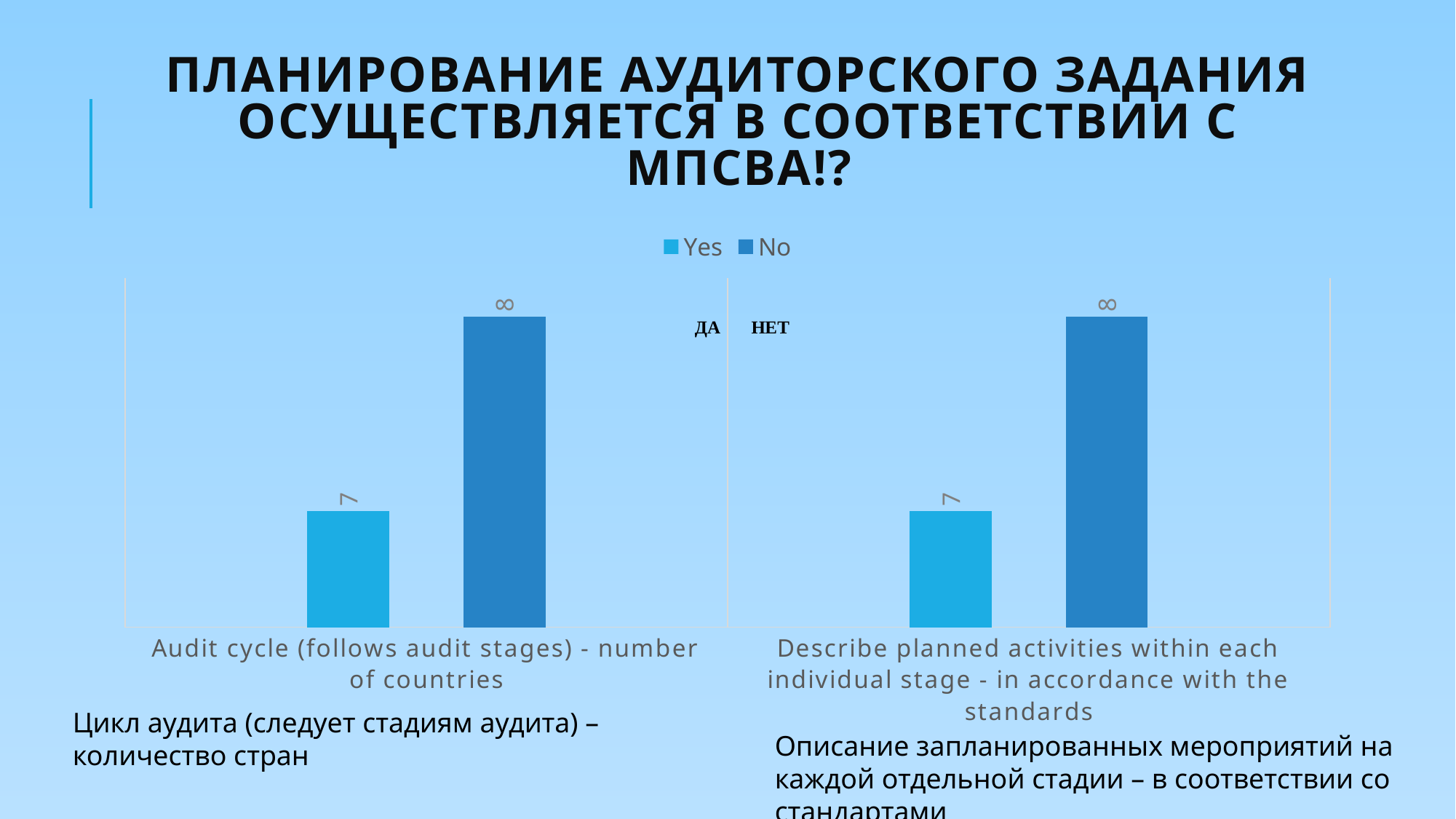
How many categories are shown on the x axis? 2 What is the value of the No series for "Audit cycle (follows audit stages) - number of countries"? 8 How many series does the legend list? 2 Which series has the higher value for "Audit cycle (follows audit stages) - number of countries", Yes or No? No What are the two entries listed in the chart legend? Yes and No What is the value of the Yes series for "Describe planned activities within each individual stage - in accordance with the standards"? 7 Which series is shown in the darker blue colour? No What kind of chart is shown on the slide? bar chart What is the difference between the No and Yes values for "Audit cycle (follows audit stages) - number of countries"? 1 What is the value of the Yes series for "Audit cycle (follows audit stages) - number of countries"? 7 What is the difference between the No and Yes values for "Describe planned activities within each individual stage - in accordance with the standards"? 1 What is the value of the No series for "Describe planned activities within each individual stage - in accordance with the standards"? 8